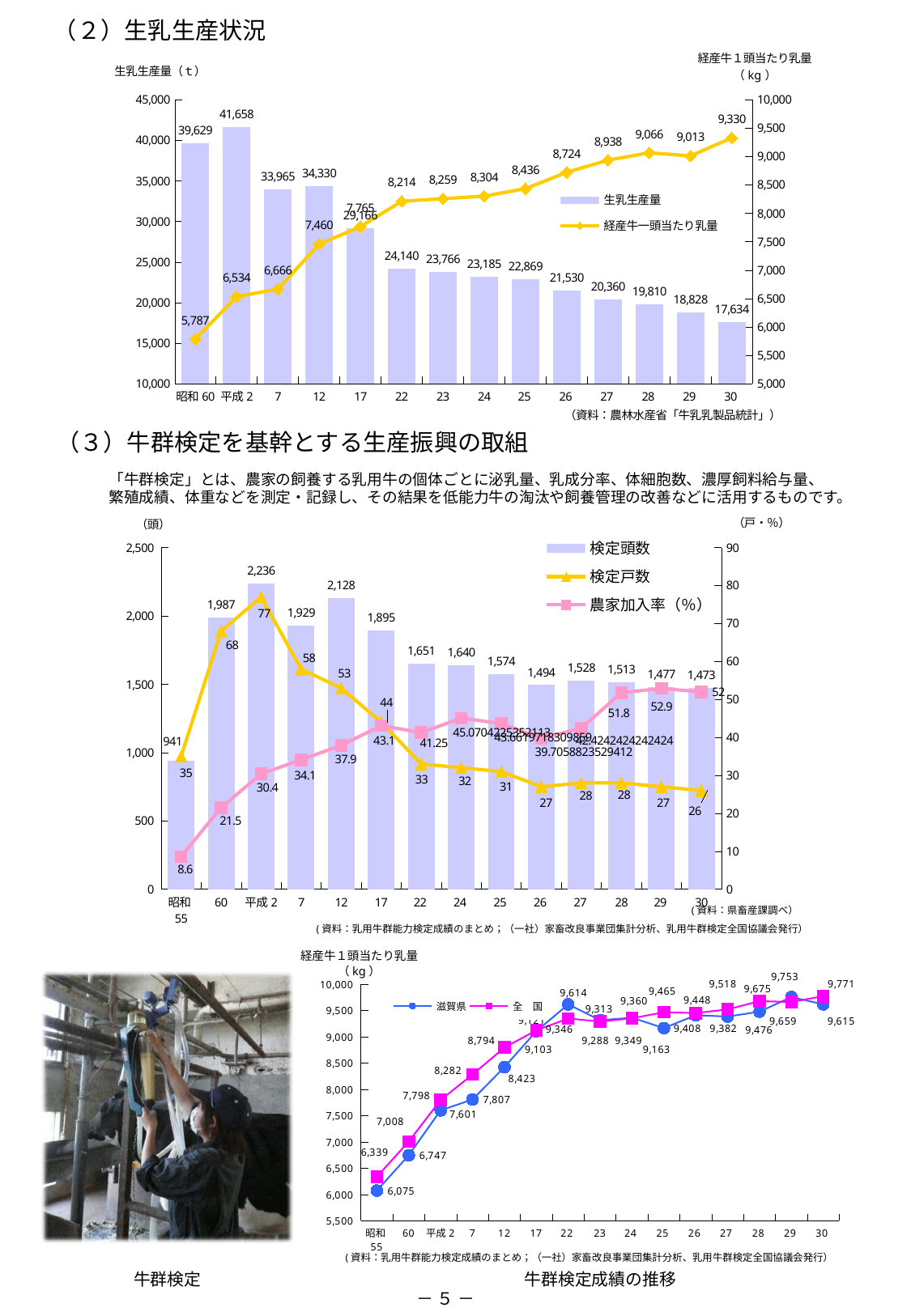
In the top chart (生乳生産状況), what is the 生乳生産量 value for 平成2? 41,658 In the top chart (生乳生産状況), what is the 経産牛一頭当たり乳量 value for 30? 9,330 In the bottom-right chart (牛群検定成績の推移), which is larger for 30, 滋賀県 or 全国? 全国 In the middle chart (牛群検定), what is the 農家加入率 value for 29? 52.9 In the middle chart (牛群検定), which category has the highest 検定戸数? 平成2 In the top chart (生乳生産状況), which category has the lowest 生乳生産量? 30 In the top chart (生乳生産状況), does 経産牛一頭当たり乳量 generally rise or fall from 昭和60 to 30? rise In the middle chart (牛群検定), what is the 検定頭数 value for 平成2? 2,236 In the bottom-right chart (牛群検定成績の推移), how many categories are on the x axis? 15 In the bottom-right chart (牛群検定成績の推移), what is the 滋賀県 value for 22? 9,614 In the middle chart (牛群検定), how many series does the legend list? 3 In the top chart (生乳生産状況), what is the difference between the 生乳生産量 values for 昭和60 and 30? 21,995